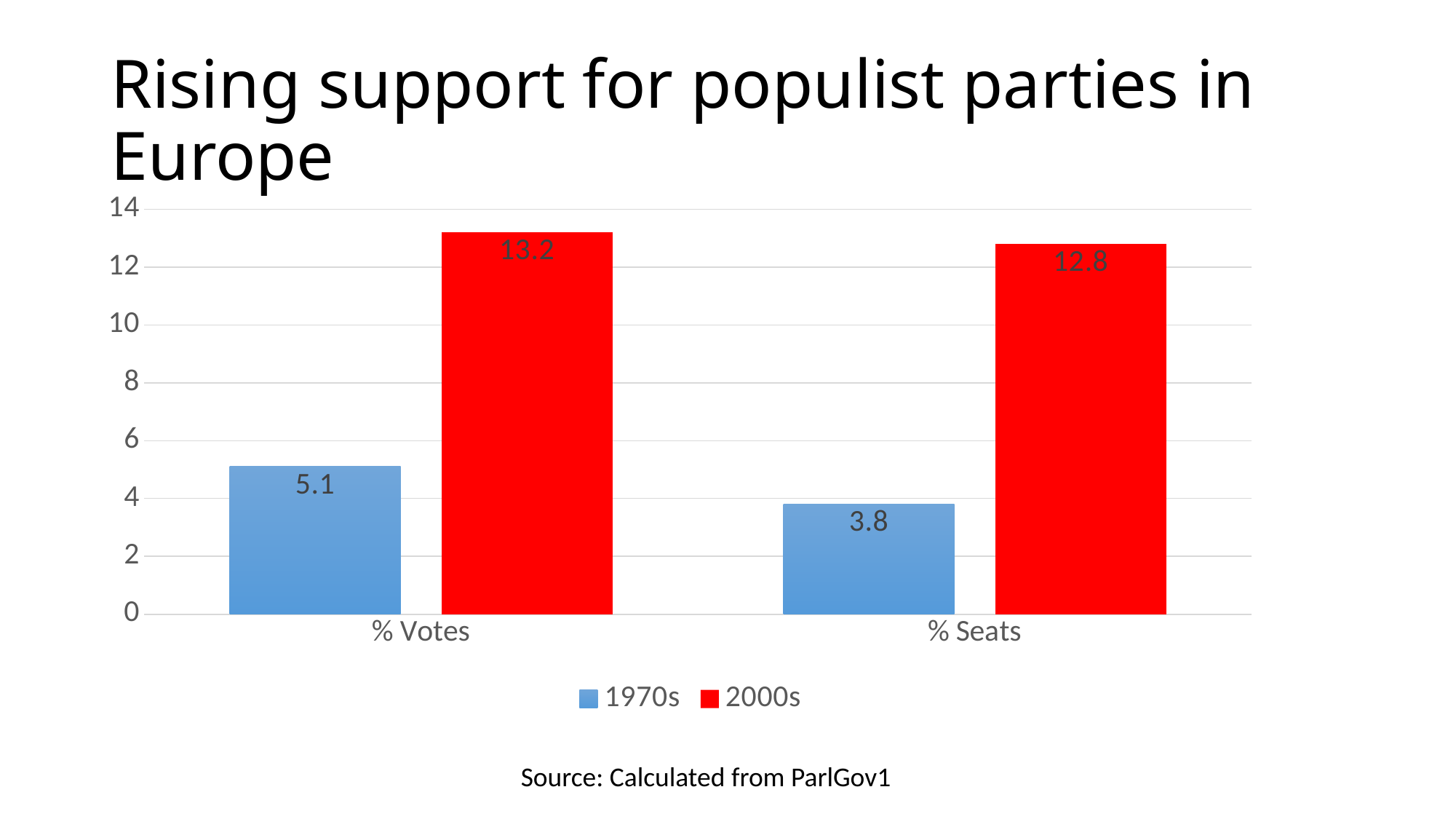
How many series does the legend list? 2 What is the value for 1970s in the % Seats category? 3.8 How many categories are shown on the x axis? 2 Which bar has the lowest value on the chart? 1970s, % Seats What is the difference between the 2000s and 1970s values for % Seats? 9 Which is larger: the 1970s value for % Votes or the 1970s value for % Seats? % Votes Which bar has the highest value on the chart? 2000s, % Votes What kind of chart is shown on the slide? Bar chart What is the value for 2000s in the % Votes category? 13.2 What is the difference between the 2000s and 1970s values for % Votes? 8.1 What is the value for 1970s in the % Votes category? 5.1 What is the value for 2000s in the % Seats category? 12.8